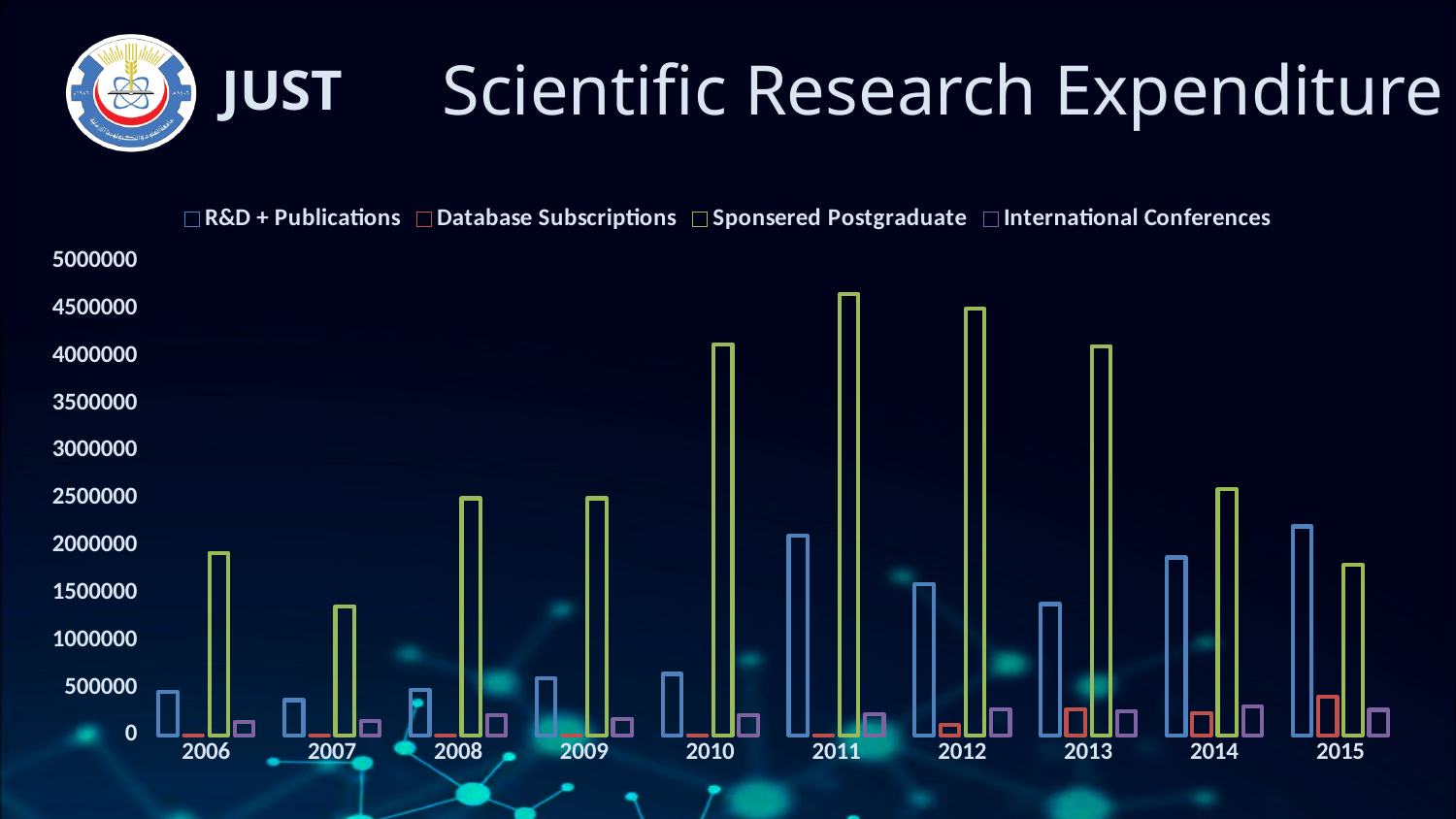
Is the R&D + Publications value for 2011 greater or less than 1500000? greater What type of chart is shown on the slide? bar chart In which year is Database Subscriptions expenditure highest? 2015 In which year is Sponsered Postgraduate expenditure lowest? 2007 Does Sponsered Postgraduate expenditure rise or fall from 2011 to 2015? fall Is the Sponsered Postgraduate value for 2007 greater or less than 1500000? less In which year is Sponsered Postgraduate expenditure highest? 2011 How many series does the legend list? 4 In 2015, which is larger: R&D + Publications or Sponsered Postgraduate? R&D + Publications Is the Sponsered Postgraduate value for 2011 greater or less than 4500000? greater How many years are shown on the x axis? 10